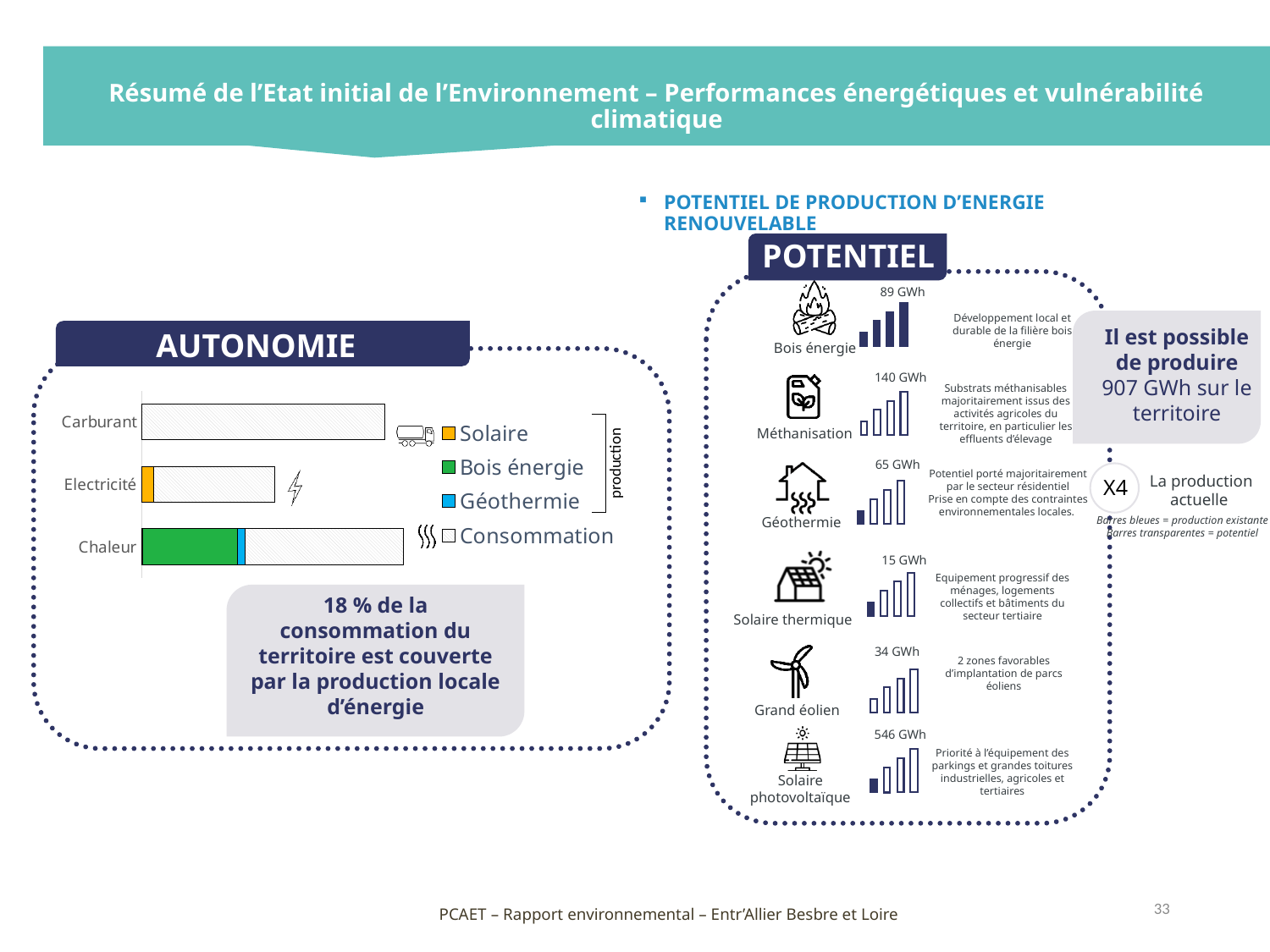
In the POTENTIEL section on the right, which energy source has the highest potential production value? Solaire photovoltaïque In the AUTONOMIE bar chart, is the production bar for Chaleur larger or smaller than the production bar for Electricité? larger In the POTENTIEL section on the right, what is the difference between the potential for Méthanisation and the potential for Bois énergie? 51 GWh How many series does the legend of the AUTONOMIE bar chart list? 4 In the POTENTIEL section on the right, what is the potential production value for Méthanisation? 140 GWh In the AUTONOMIE bar chart, which series appears in the Electricité bar? Solaire In the POTENTIEL section on the right, which energy source has the lowest potential production value? Solaire thermique How many categories are shown on the y axis of the AUTONOMIE bar chart? 3 In the AUTONOMIE bar chart, which category has the largest local production bar? Chaleur In the AUTONOMIE bar chart, which category shows no local production at all? Carburant In the AUTONOMIE bar chart, which series is shown in green? Bois énergie What kind of chart is the AUTONOMIE chart on the left of the slide? bar chart